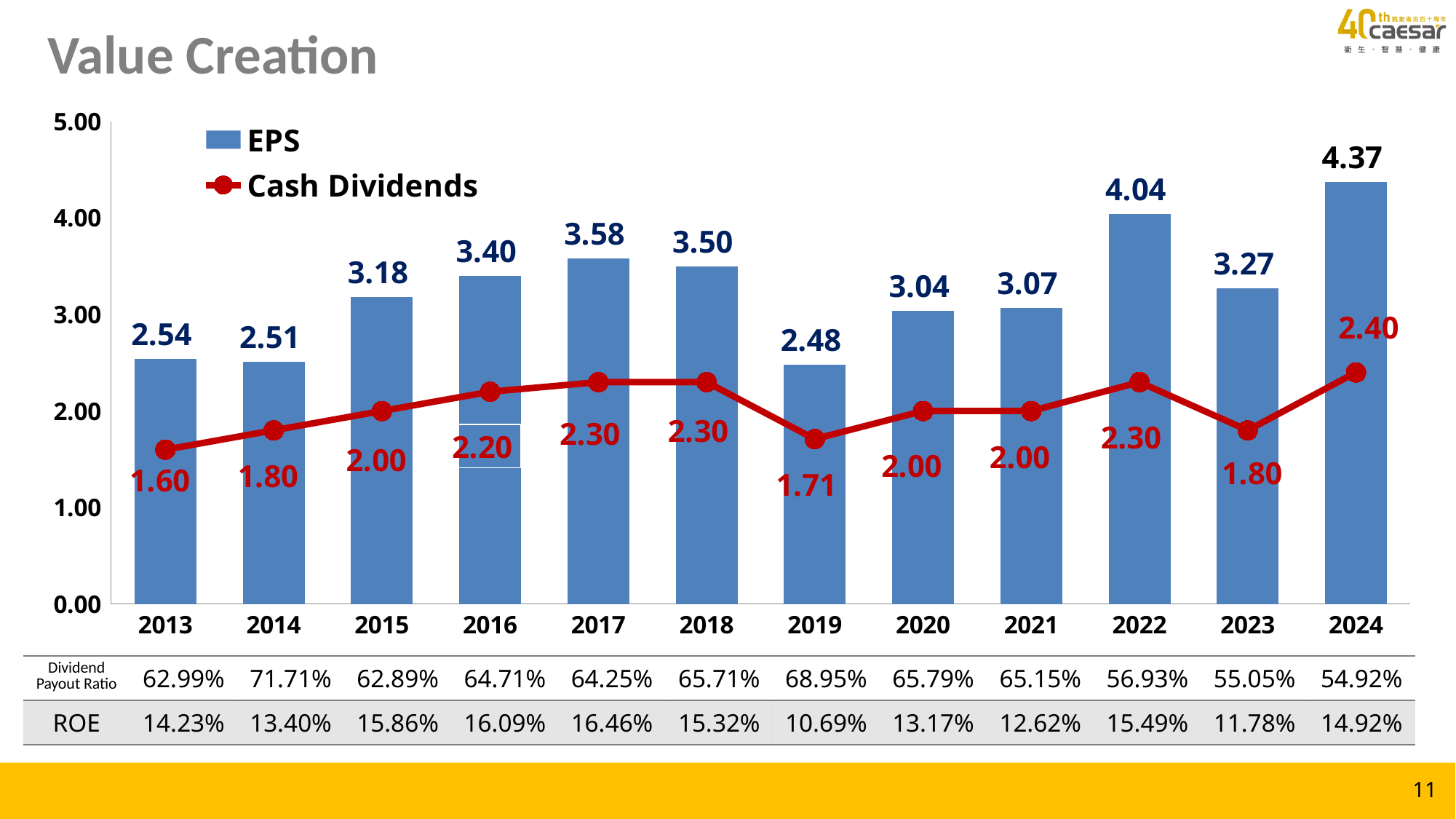
What is the difference between the EPS for 2024 and the EPS for 2023? 1.10 Which is larger, the EPS for 2017 or the EPS for 2018? 2017 What is the EPS value for 2016? 3.40 Which year has the lowest Cash Dividends value? 2013 Which year has the highest EPS? 2024 Is the EPS value for 2022 greater or less than 4.00? greater How many years are shown on the x axis of the chart? 12 What colour is the Cash Dividends line in the chart? Red What kind of chart is used to show EPS? Bar chart How many series does the chart legend list? 2 What is the Cash Dividends value for 2019? 1.71 Do the Cash Dividends values rise or fall from 2013 to 2018? Rise